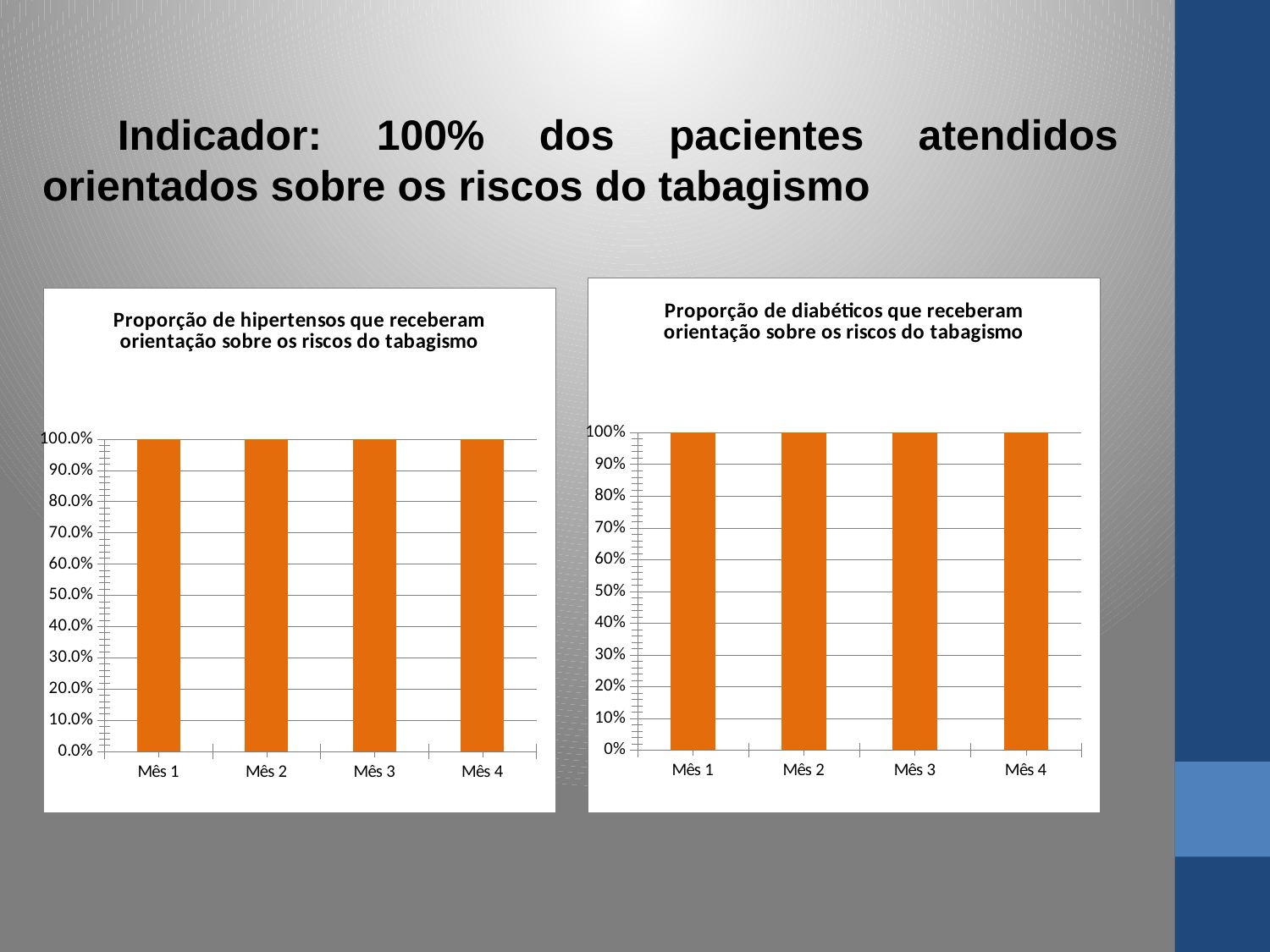
How many categories are shown on the x axis of the left chart (Proporção de hipertensos)? 4 In the left chart (Proporção de hipertensos), do the values rise, fall, or stay the same from Mês 1 to Mês 4? Stay the same What kind of chart is the left chart (Proporção de hipertensos)? Bar chart In the right chart (Proporção de diabéticos que receberam orientação sobre os riscos do tabagismo), what is the value for Mês 4? 100% What is the title of the right chart? Proporção de diabéticos que receberam orientação sobre os riscos do tabagismo In the left chart (Proporção de hipertensos), what is the difference between the values for Mês 2 and Mês 4? 0.0% What kind of chart is the right chart (Proporção de diabéticos)? Bar chart In the left chart (Proporção de hipertensos), what is the value for Mês 3? 100.0% In the right chart (Proporção de diabéticos), is the value for Mês 3 greater or less than 50%? greater How many bars are plotted in the right chart (Proporção de diabéticos)? 4 In the right chart (Proporção de diabéticos), what is the value for Mês 2? 100% In the left chart (Proporção de hipertensos que receberam orientação sobre os riscos do tabagismo), what is the value for Mês 1? 100.0%